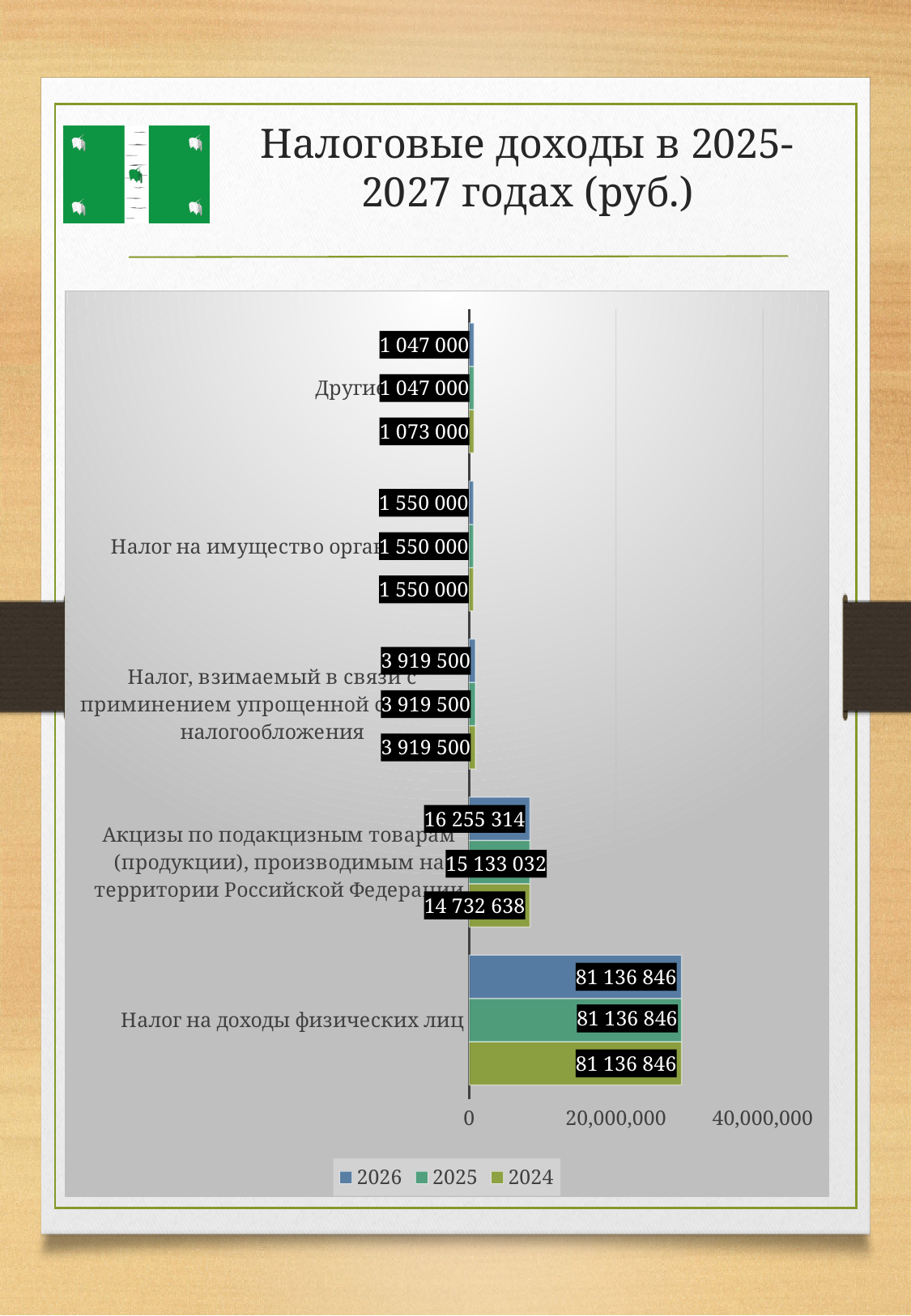
What is the 2024 value for the category Другие? 1 073 000 What kind of chart is shown on the slide? Bar chart What is the 2025 value for Налог, взимаемый в связи с применением упрощенной системы налогообложения? 3 919 500 What is the difference between the 2024 and 2026 values for Другие? 26 000 How many series does the legend list? 3 What is the 2026 value for Акцизы по подакцизным товарам (продукции), производимым на территории Российской Федерации? 16 255 314 What is the difference between the 2026 and 2025 values for Акцизы по подакцизным товарам? 1 122 282 Which category has the lowest value for 2026? Другие For Акцизы по подакцизным товарам, which is larger: the 2026 value or the 2024 value? 2026 Which category has the highest values on the chart? Налог на доходы физических лиц How many tax categories are plotted on the chart? 5 What is the 2024 value for Акцизы по подакцизным товарам (продукции), производимым на территории Российской Федерации? 14 732 638